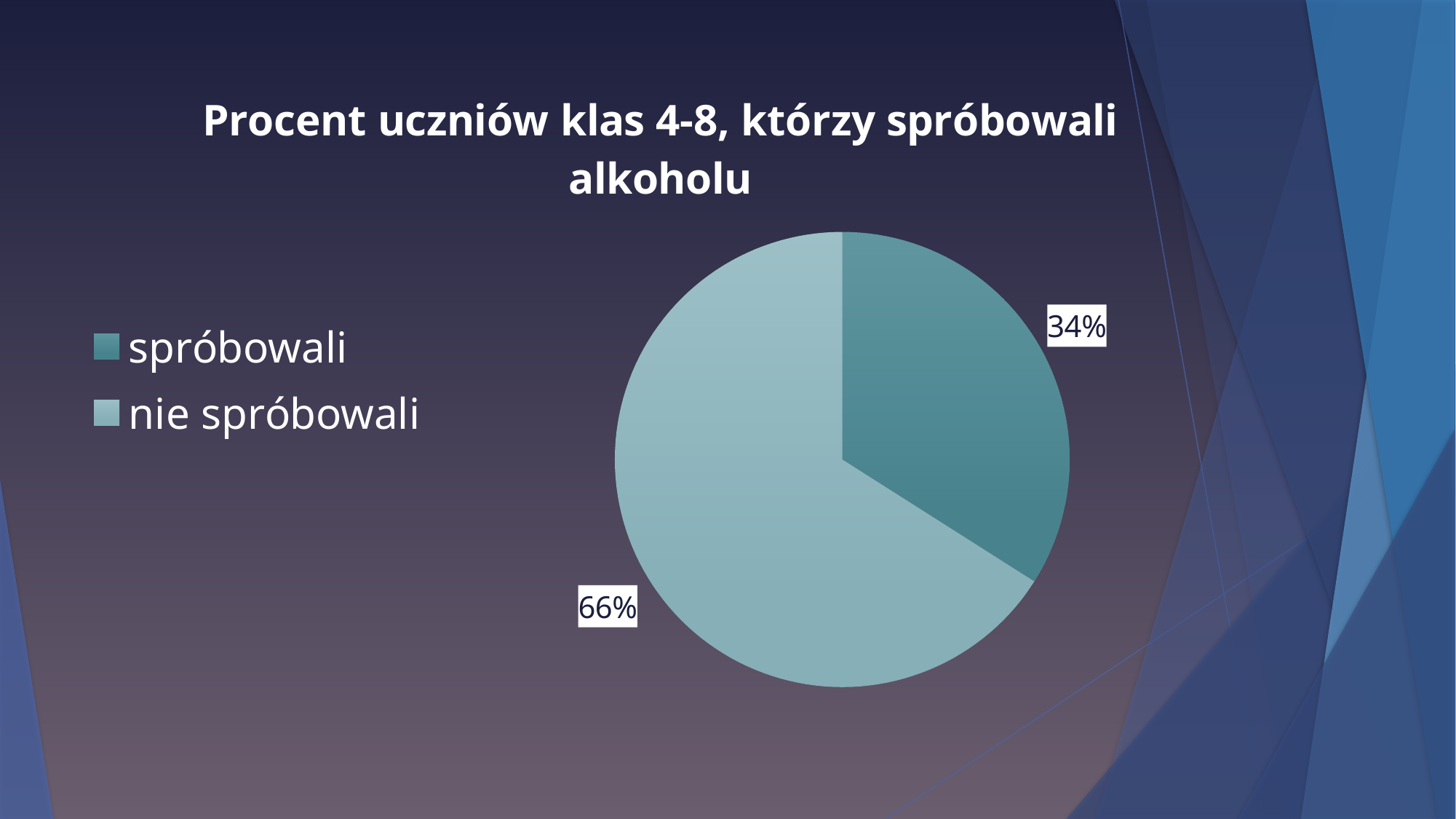
Which is larger, the share for "spróbowali" or for "nie spróbowali"? nie spróbowali What is the title of the chart? Procent uczniów klas 4-8, którzy spróbowali alkoholu Which legend entry is listed first? spróbowali What percentage of students is shown for "spróbowali"? 34% How many slices does the pie chart have? 2 Which category has the smallest share of the pie? spróbowali What percentage of students is shown for "nie spróbowali"? 66% What is the difference in percentage points between "nie spróbowali" and "spróbowali"? 32 What share of the pie does the "spróbowali" slice represent? 34% What kind of chart is shown on the slide? pie chart Which category has the largest share of the pie? nie spróbowali How many entries does the legend list? 2